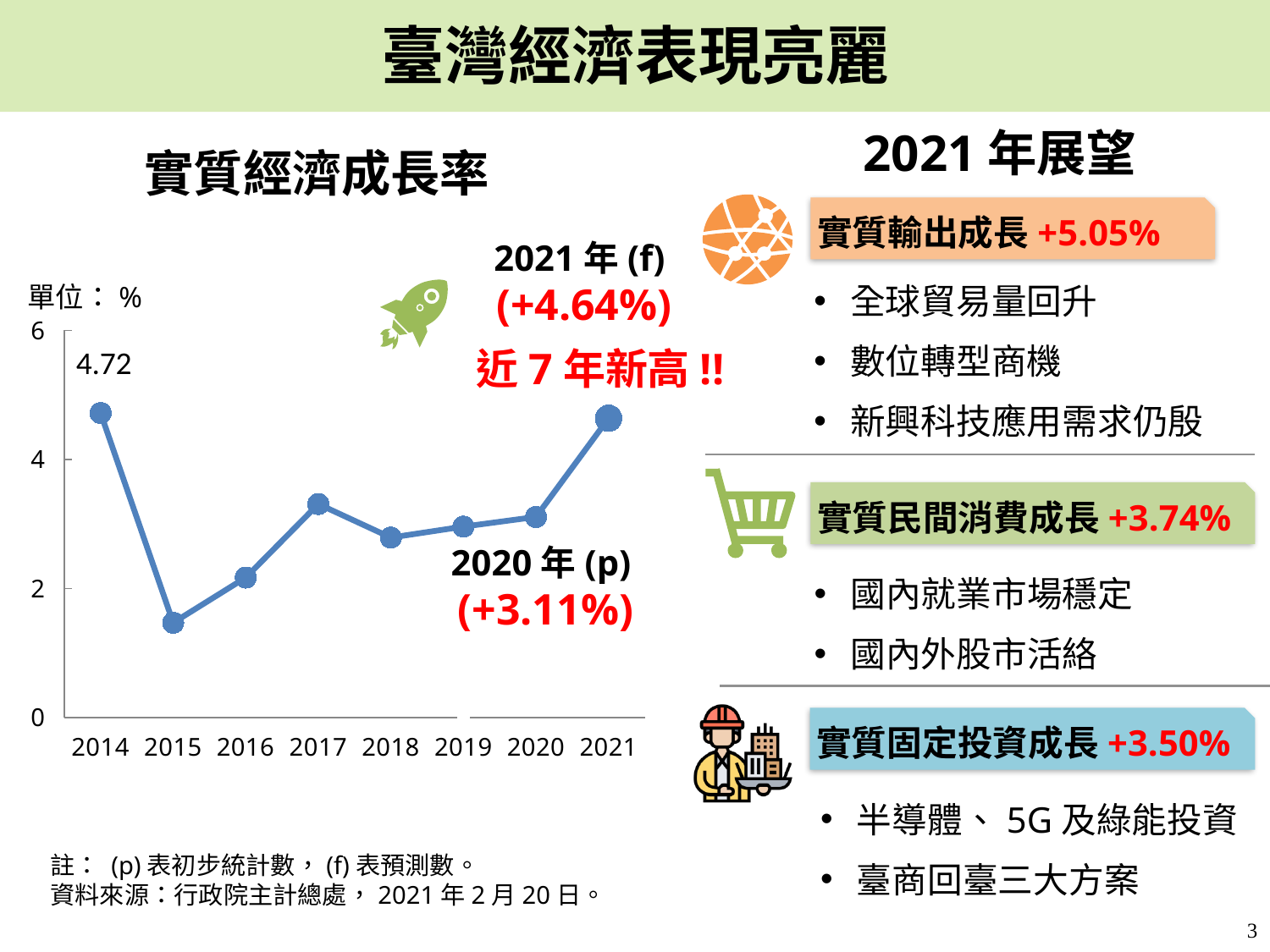
What growth rate is shown for 2020 (p) in the 實質經濟成長率 chart? +3.11% What type of chart is used to show 實質經濟成長率? line chart Is the value for 2015 in the 實質經濟成長率 chart greater or less than 2? less What is the difference between the 2021 (f) and 2020 (p) values in the 實質經濟成長率 chart? 1.53 Which year has the highest value in the 實質經濟成長率 chart? 2014 What is the value for 2014 in the 實質經濟成長率 chart? 4.72 How many years are plotted in the 實質經濟成長率 chart? 8 Which year has the lowest value in the 實質經濟成長率 chart? 2015 What growth rate is forecast for 2021 (f) in the 實質經濟成長率 chart? +4.64% Do the values in the 實質經濟成長率 chart rise or fall from 2018 to 2021? rise Which is larger in the 實質經濟成長率 chart, the value for 2017 or the value for 2018? 2017 Is the value for 2018 in the 實質經濟成長率 chart greater or less than 4? less